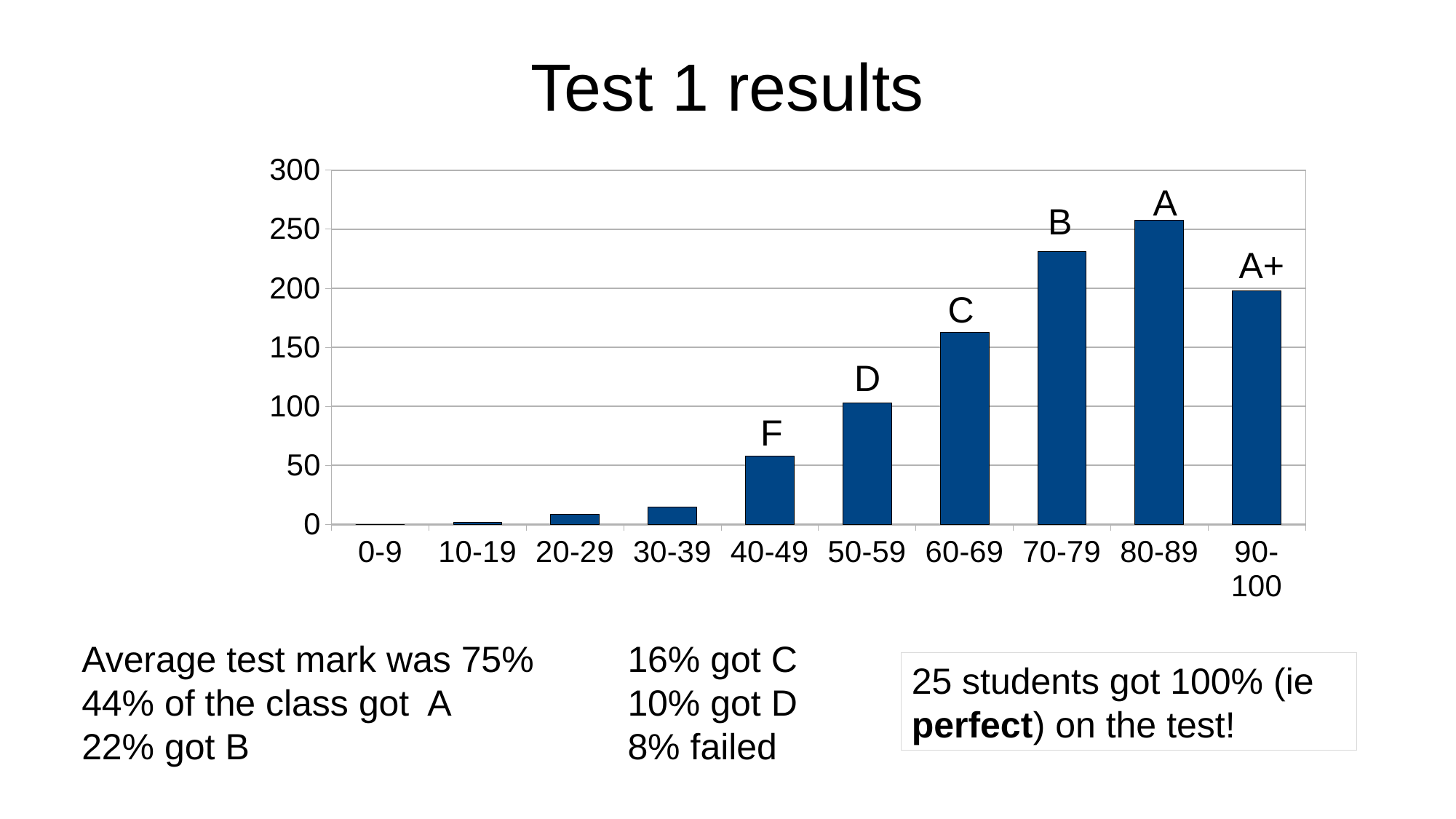
Is the value for the 80-89 range greater or less than 250? greater What is the title of the chart? Test 1 results Which bar is taller, 70-79 or 90-100? 70-79 Which bar is taller, 50-59 or 60-69? 60-69 Is the value for the 40-49 range greater or less than 50? greater Which score range has the tallest bar? 80-89 What kind of chart is shown on the slide? bar chart Which score range has the shortest bar? 0-9 What grade letter is printed above the 80-89 bar? A Is the value for the 60-69 range greater or less than 150? greater How many score ranges (categories) are shown on the x axis? 10